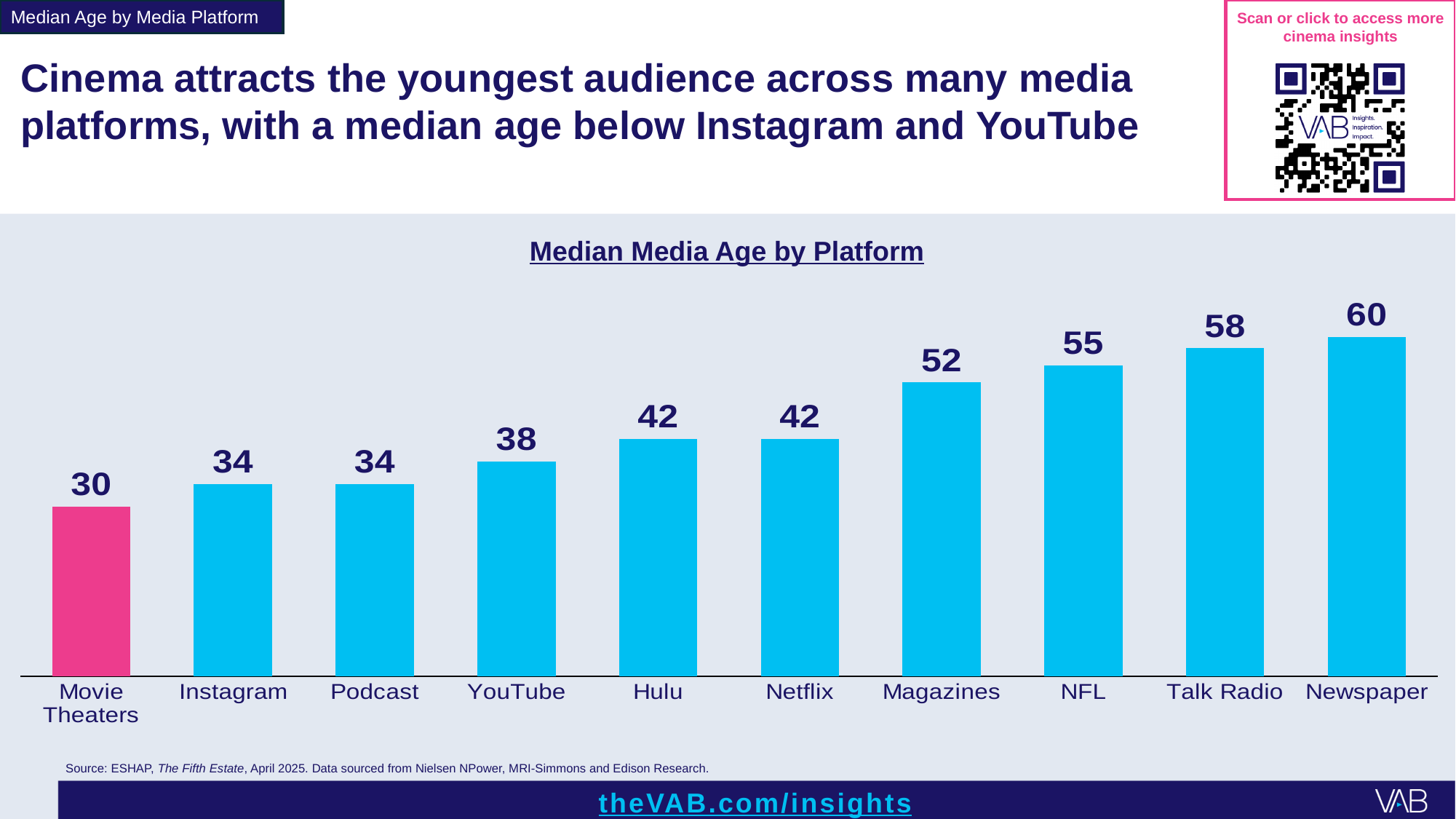
What is the median media age for Talk Radio? 58 What is the difference in median media age between NFL and YouTube? 17 How many platforms are shown in the chart? 10 What is the median media age for Movie Theaters? 30 Do the median media age values rise or fall from left to right across the platforms? Rise Which has a higher median media age, Hulu or Magazines? Magazines Which platform has the lowest median media age? Movie Theaters Which platform has the highest median media age? Newspaper What is the title of the chart? Median Media Age by Platform What kind of chart is shown on the slide? Bar chart What is the difference in median media age between Newspaper and Movie Theaters? 30 What is the median media age for Magazines? 52